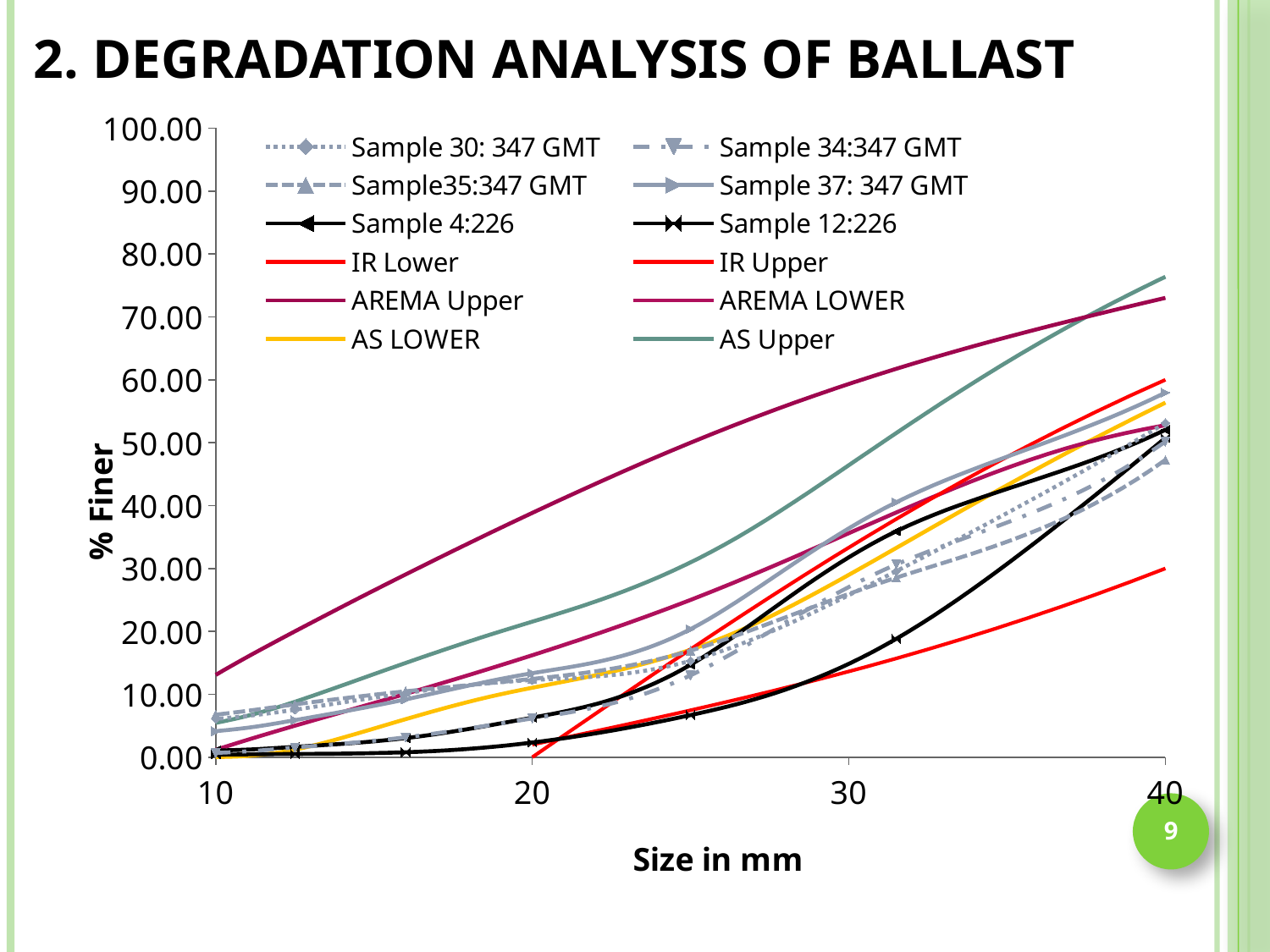
At 40 mm, which is larger: AS Upper or IR Lower? AS Upper Which series has the highest % Finer at 10 mm? AREMA Upper What is the title of the x axis? Size in mm At 20 mm, which is larger: AREMA Upper or IR Lower? AREMA Upper Is the value for Sample 12:226 at 20 mm greater or less than 10? less Does the AS Upper line rise or fall as size increases from 10 mm to 40 mm? rise Is the value for AS Upper at 40 mm greater or less than 70? greater What kind of chart is shown on the slide? line chart How many series does the legend list? 12 What is the title of the y axis? % Finer